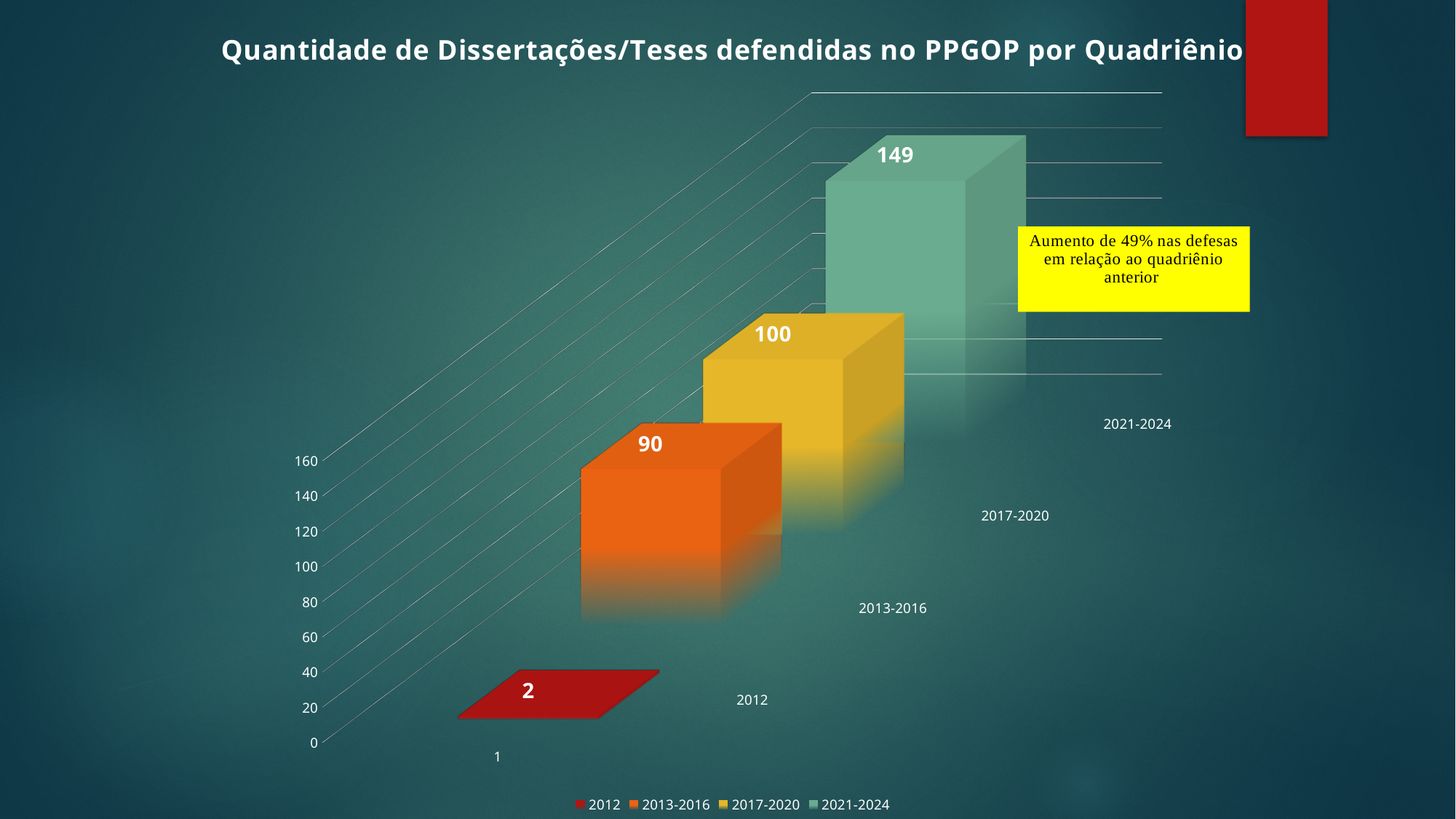
What kind of chart is shown? Bar chart Which is larger, the value for 2013-2016 or the value for 2017-2020? 2017-2020 What is the difference between the values for 2021-2024 and 2017-2020? 49 Which period has the highest value? 2021-2024 Which period has the lowest value? 2012 What is the value for 2013-2016? 90 What is the value for 2021-2024? 149 What is the value for 2017-2020? 100 Do the values rise or fall from 2012 to 2021-2024? Rise How many series does the legend list? 4 What is the title of the chart? Quantidade de Dissertações/Teses defendidas no PPGOP por Quadriênio What is the value for 2012? 2